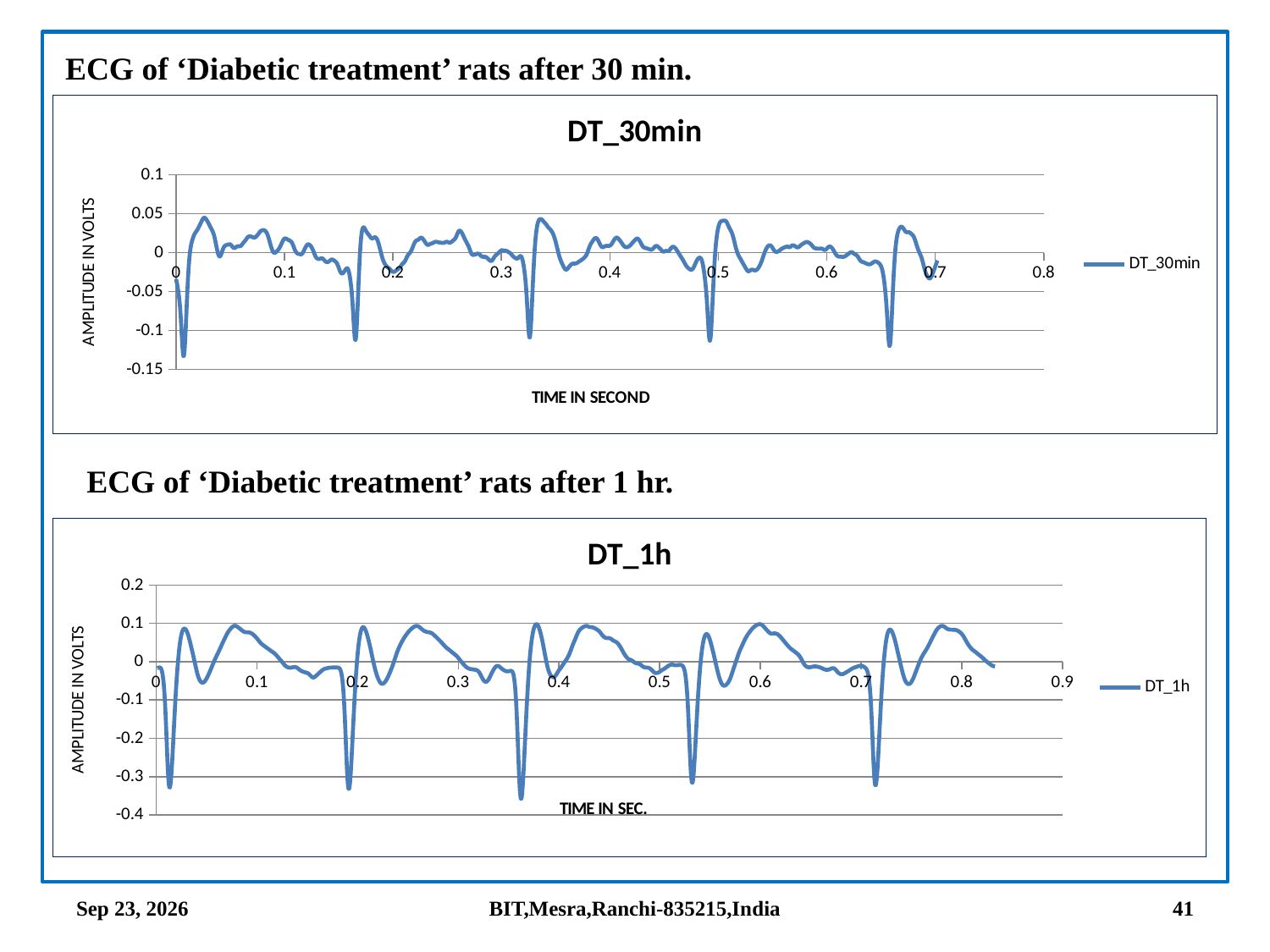
How many sharp downward spikes (troughs below -0.2) appear in the DT_1h chart? 5 In the DT_30min chart, is the highest value of the trace greater or less than 0.1? less In the DT_30min chart, is the lowest value of the trace greater or less than -0.1? less How many sharp downward spikes (troughs below -0.1) appear in the DT_30min chart? 5 What kind of chart is the DT_1h chart? line chart What is the y-axis label of the DT_1h chart? AMPLITUDE IN VOLTS How many series does the legend of the DT_30min chart list? 1 How many series does the legend of the DT_1h chart list? 1 What is the title of the upper chart on the slide? DT_30min What kind of chart is the DT_30min chart? line chart In the DT_1h chart, is the highest value of the trace greater or less than 0.2? less